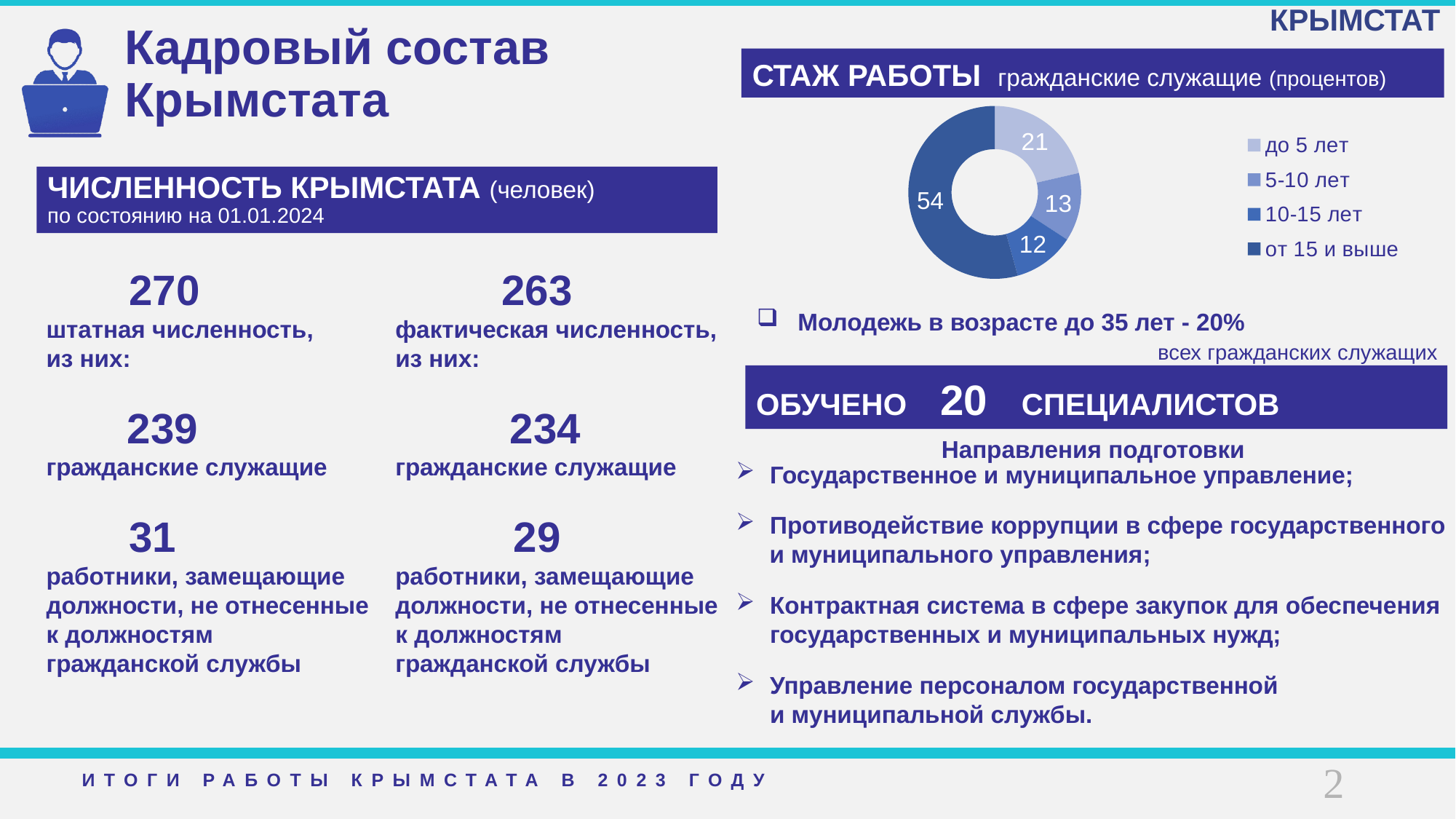
How many categories does the «СТАЖ РАБОТЫ» chart show? 4 In the «СТАЖ РАБОТЫ» chart, what is the value for «10-15 лет»? 12 What share of the «СТАЖ РАБОТЫ» doughnut does the «от 15 и выше» slice represent? 54% In the «СТАЖ РАБОТЫ» chart, what is the value for «до 5 лет»? 21 In the «СТАЖ РАБОТЫ» chart, which category has the largest value? от 15 и выше How many entries does the legend of the «СТАЖ РАБОТЫ» chart list? 4 In the «СТАЖ РАБОТЫ» chart, what is the value for «5-10 лет»? 13 In the «СТАЖ РАБОТЫ» chart, what is the difference between the values for «от 15 и выше» and «до 5 лет»? 33 What type of chart is shown under the heading «СТАЖ РАБОТЫ»? Doughnut (pie) chart In the «СТАЖ РАБОТЫ» chart, what is the value for «от 15 и выше»? 54 In the «СТАЖ РАБОТЫ» chart, which category has the smallest value? 10-15 лет In the «СТАЖ РАБОТЫ» chart, which is larger: the value for «до 5 лет» or for «5-10 лет»? до 5 лет